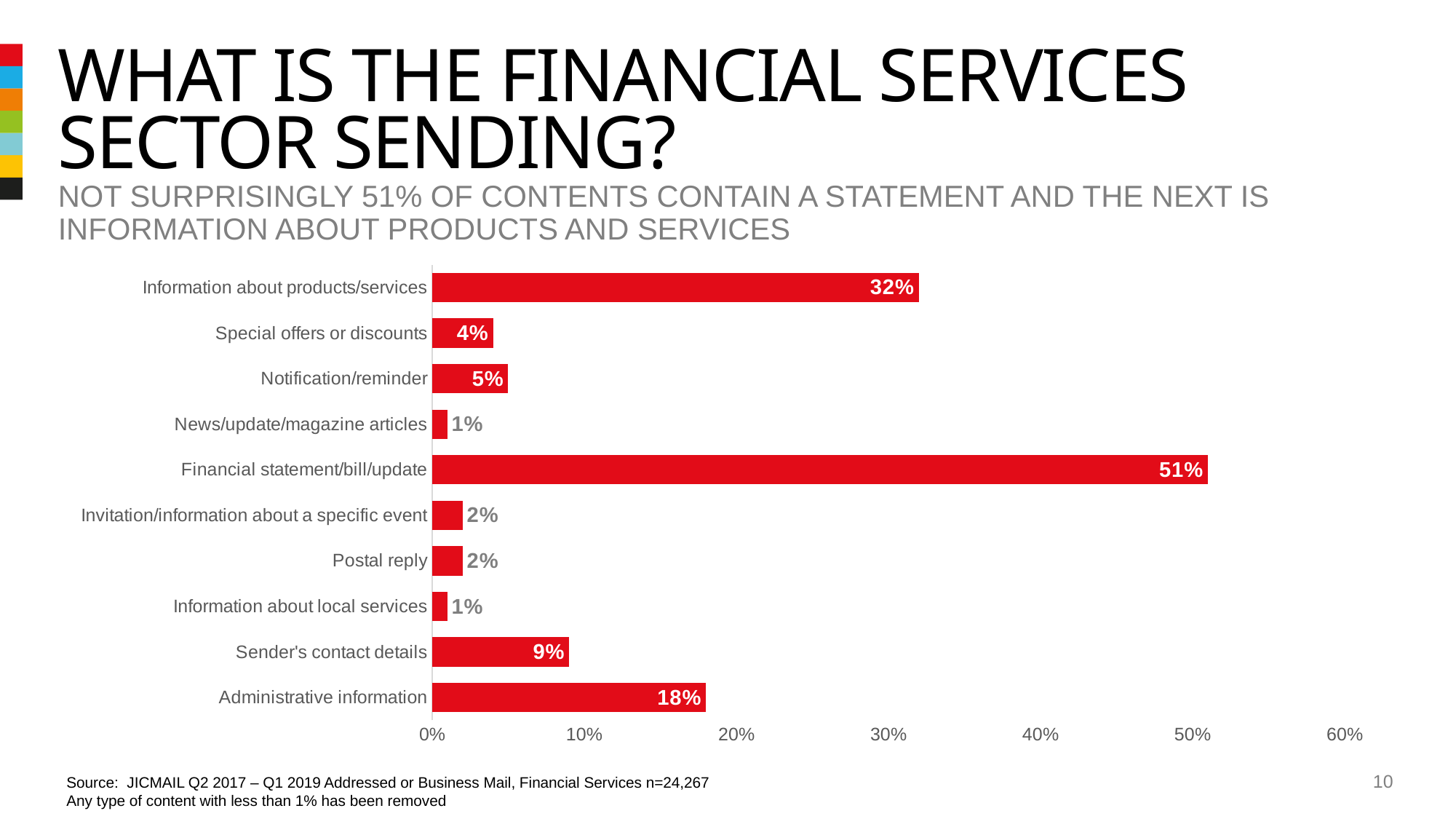
What is the value for Sender's contact details? 9% How many categories are shown in the chart? 10 Is the value for Financial statement/bill/update greater or less than 50%? greater What is the value for Financial statement/bill/update? 51% What is the difference between Administrative information and Sender's contact details? 9% What kind of chart is shown on the slide? Bar chart What is the difference between Financial statement/bill/update and Information about products/services? 19% What is the value for Postal reply? 2% Which category has the highest value? Financial statement/bill/update What is the value for Information about products/services? 32% What is the value for Administrative information? 18% Which is larger, Notification/reminder or Special offers or discounts? Notification/reminder